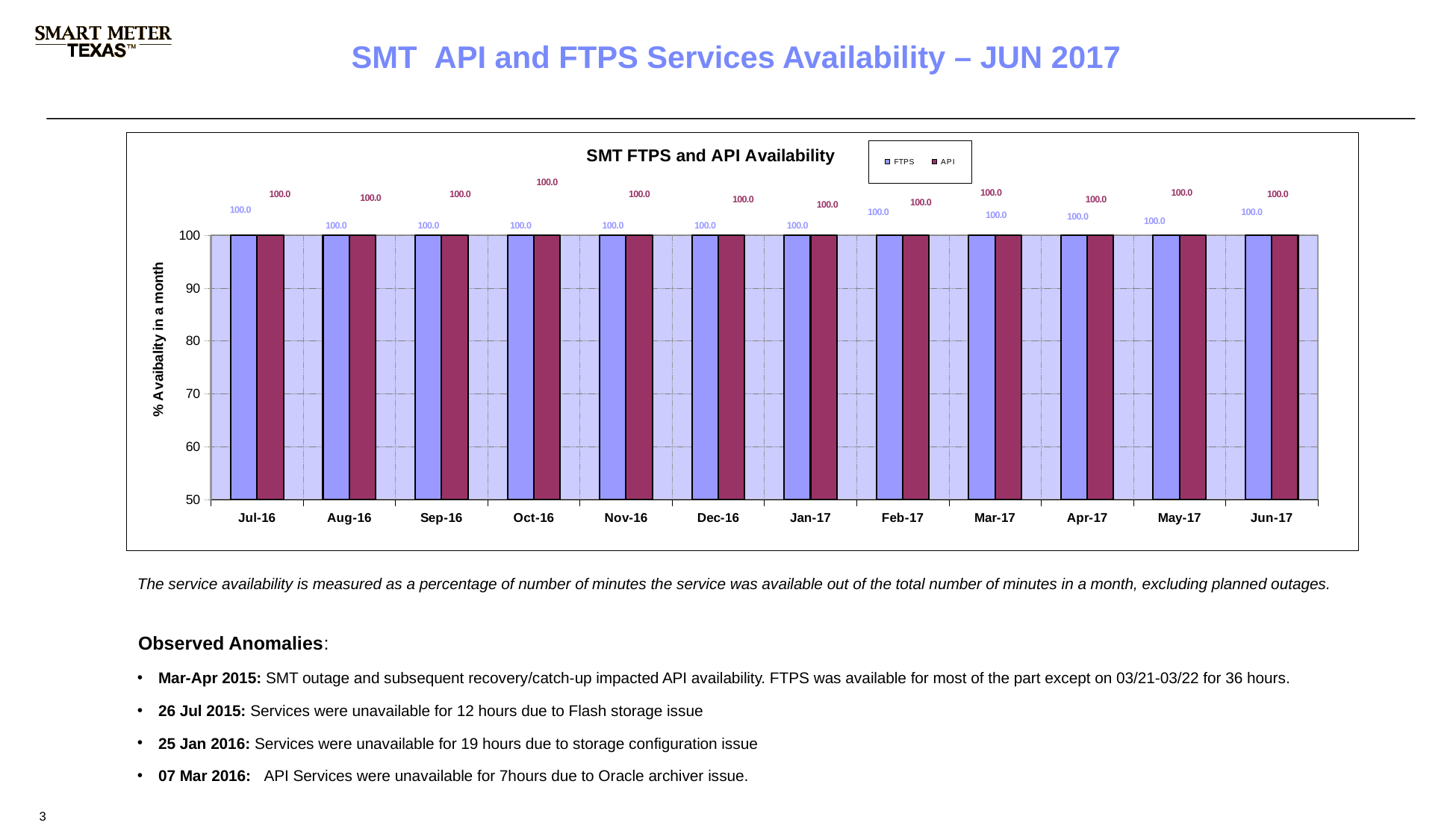
What is the API availability value for Jun-17? 100.0 Do the FTPS availability values rise, fall, or stay flat from Jul-16 to Jun-17? Stay flat What is the API availability value for Oct-16? 100.0 What kind of chart is shown on the slide? Bar chart What is the FTPS availability value for Jan-17? 100.0 How many months are shown on the x axis of the chart? 12 Is the API availability value for Dec-16 greater or less than 90? greater What are the two series named in the chart legend? FTPS and API What is the difference between the FTPS and API availability values for Mar-17? 0.0 What is the FTPS availability value for Jul-16? 100.0 How many series does the chart legend list? 2 What is the title of the chart? SMT FTPS and API Availability